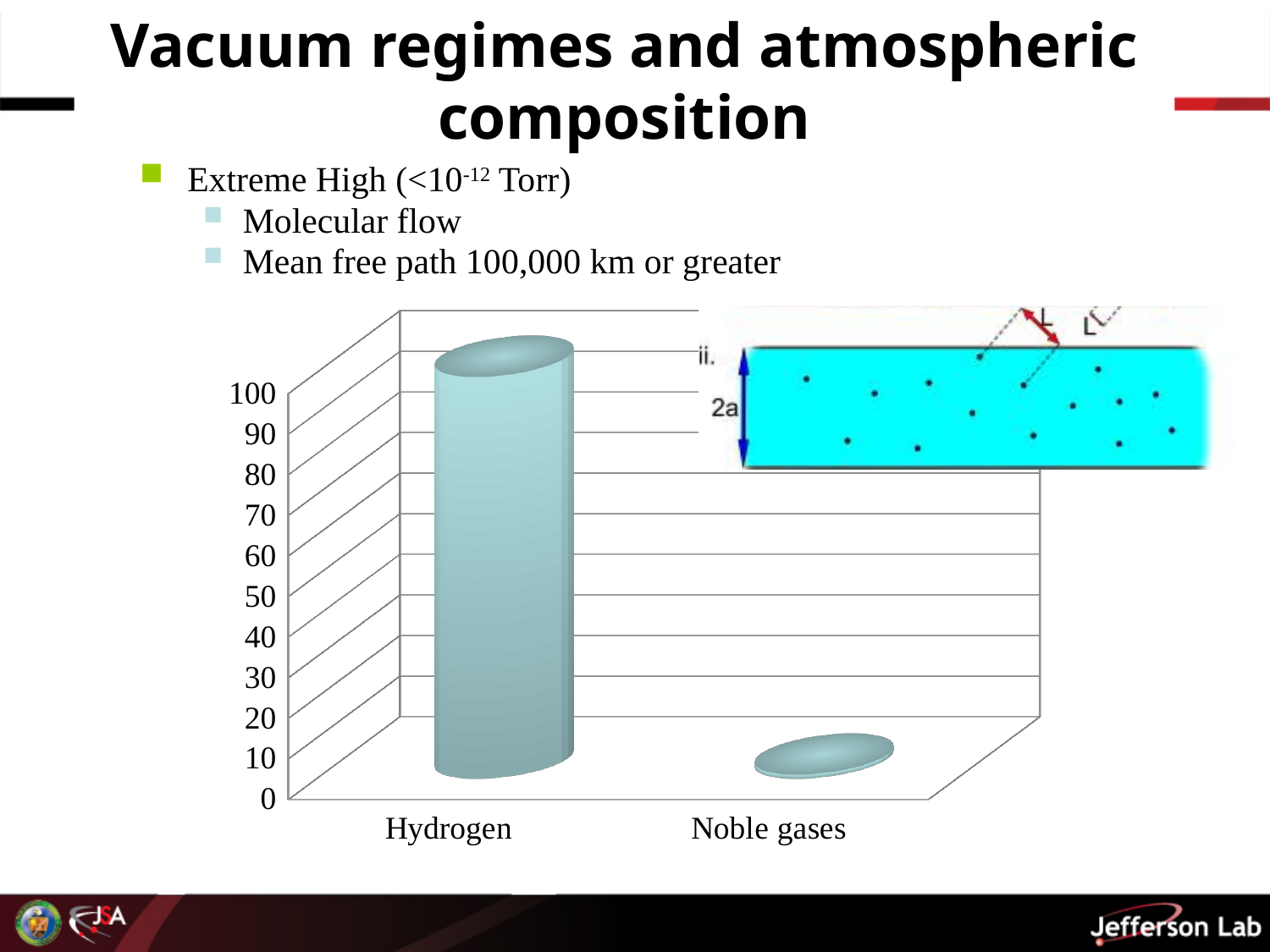
What is the highest tick value shown on the vertical axis of the chart? 100 What are the two category labels on the horizontal axis of the chart? Hydrogen and Noble gases Is the value for Noble gases greater or less than 50? less Which category has the highest value on the chart? Hydrogen Which category has the lowest value on the chart? Noble gases How many categories are plotted on the chart? 2 Is the value for Noble gases greater or less than 10? less Is the value for Hydrogen greater or less than 50? greater Which is larger, the value for Hydrogen or the value for Noble gases? Hydrogen What kind of chart is shown on the slide? bar chart